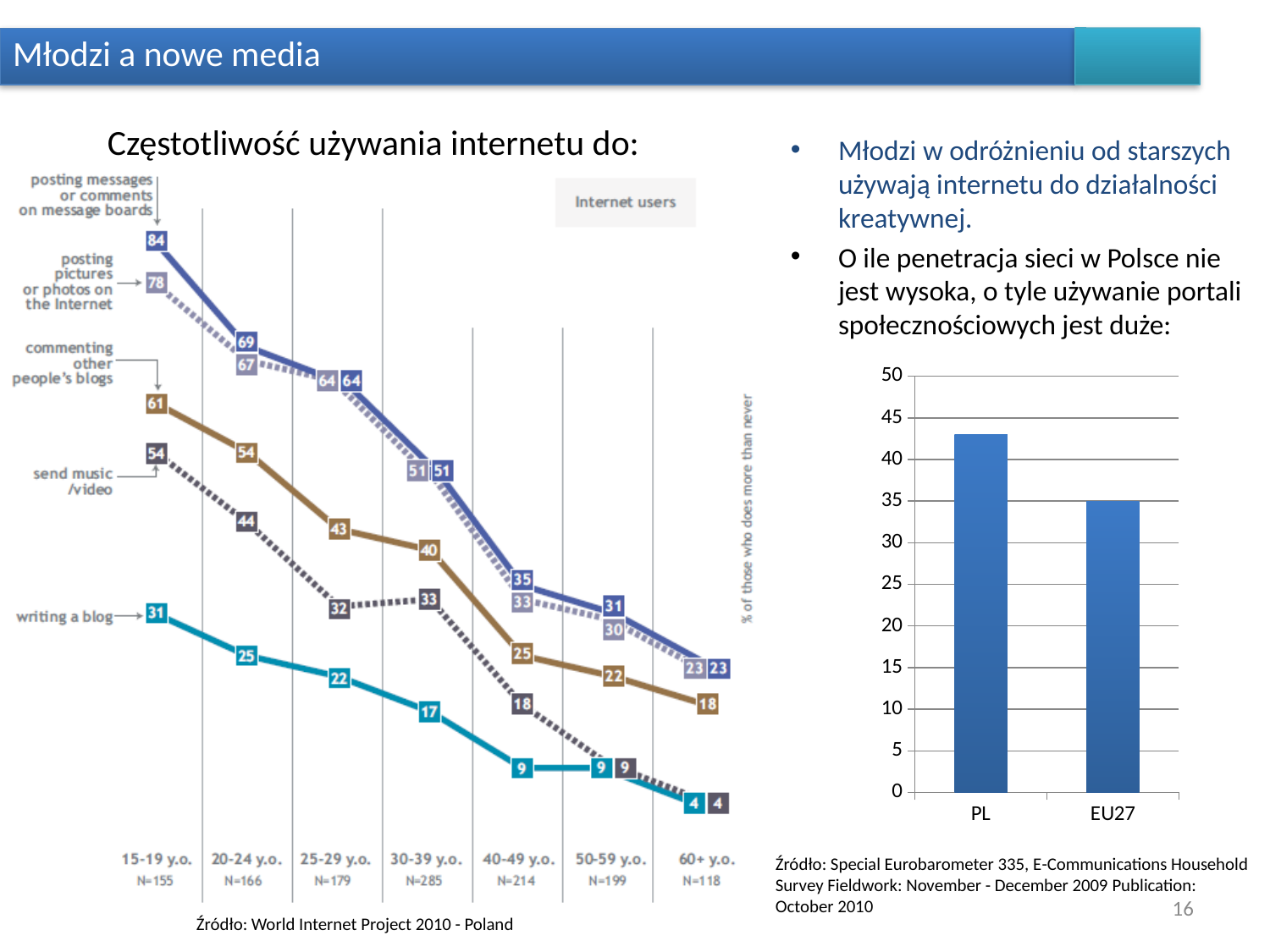
On the left chart, which age group has the highest value for writing a blog? 15-19 y.o. On the left chart, what is the value for commenting other people's blogs in the 60+ y.o. group? 18 On the left chart, what is the value for send music/video in the 40-49 y.o. group? 18 How many age groups are shown on the left chart? 7 On the left chart, do the values for writing a blog rise or fall as age increases? fall On the right chart, which is higher, PL or EU27? PL On the right chart, is the value for PL greater or less than 40? greater What kind of chart is the right chart with PL and EU27? bar chart What kind of chart is the left chart? line chart On the left chart (Częstotliwość używania internetu do:), what is the value for posting messages or comments on message boards in the 15-19 y.o. group? 84 On the left chart, what is the value for writing a blog in the 15-19 y.o. group? 31 On the left chart, what is the difference between the posting messages values for the 15-19 y.o. and 60+ y.o. groups? 61